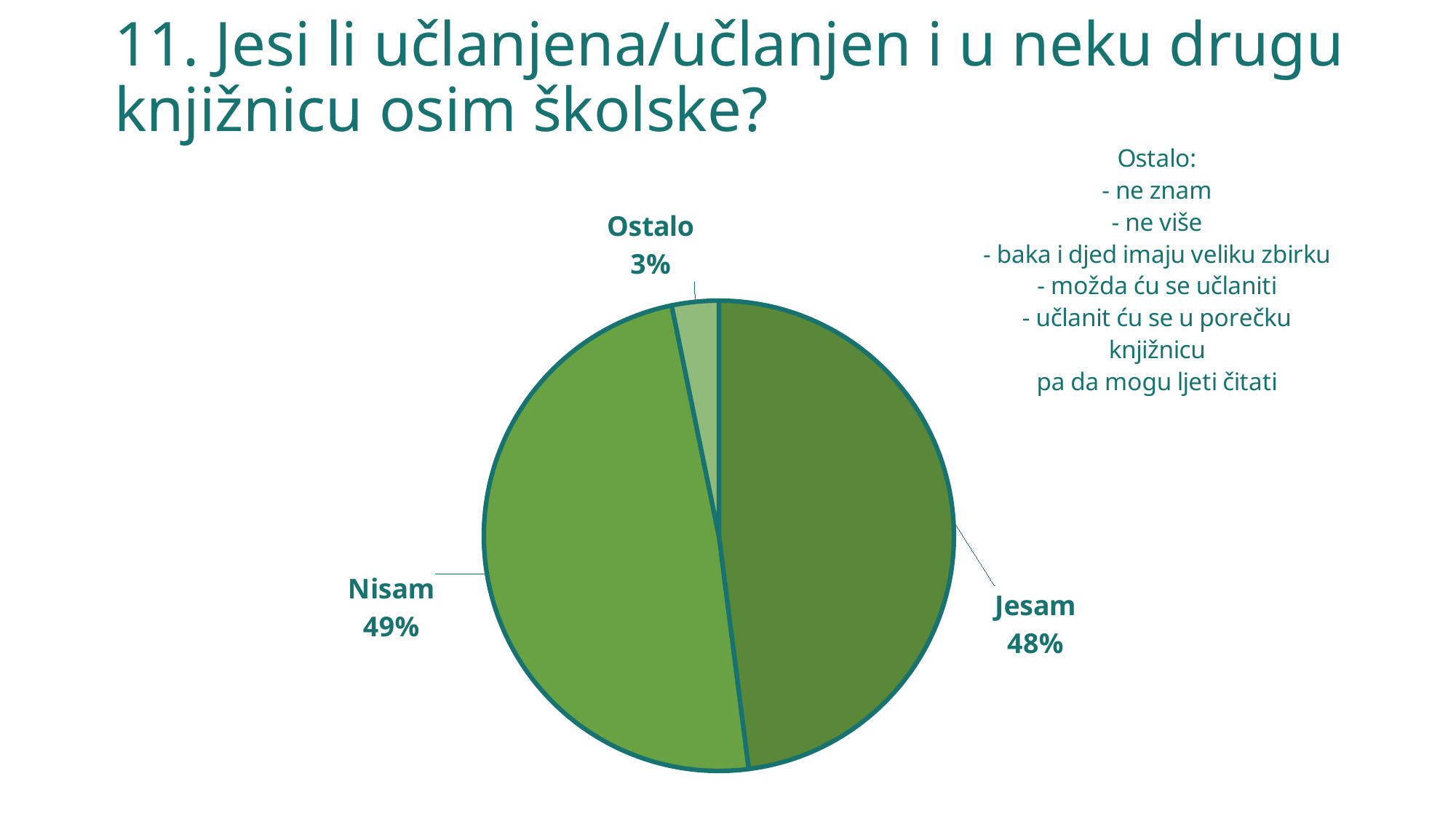
What is the difference in percentage points between the "Jesam" and "Ostalo" slices? 45% What is the title of the slide containing the pie chart? 11. Jesi li učlanjena/učlanjen i u neku drugu knjižnicu osim školske? Which slice is larger, "Jesam" or "Ostalo"? Jesam Which slice of the pie is the smallest? Ostalo How many slices does the pie chart have? 3 What kind of chart is shown on the slide? pie chart What is the combined share of the "Jesam" and "Nisam" slices? 97% Which slice of the pie is the largest, according to the printed labels? Nisam What percentage of the pie is labelled "Jesam"? 48% What percentage of the pie is labelled "Ostalo"? 3% What percentage of the pie is labelled "Nisam"? 49% What is the difference in percentage points between the "Nisam" and "Jesam" slices? 1%